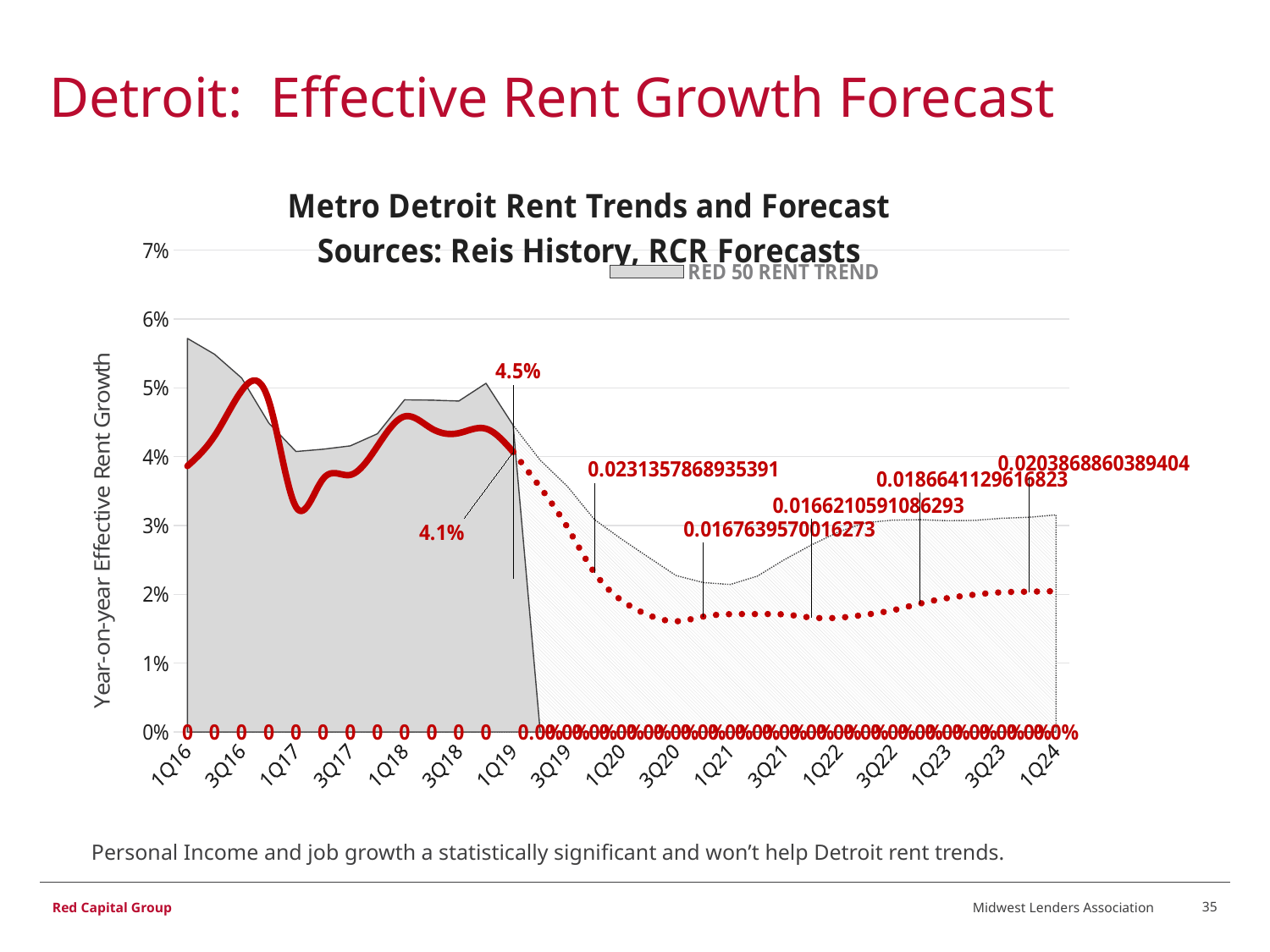
What is the highest value shown on the y axis? 7% Does the red line rise or fall between 1Q19 and 3Q20? fall What value is labeled at the end of the red dotted forecast line at 1Q24? 0.0203868860389404 Is the grey RED 50 RENT TREND area value at 1Q16 greater or less than 5%? greater What kind of chart is shown on the slide? combination area and line chart How many quarter labels are shown on the x axis? 17 Which is larger for the red line: the value at 1Q16 or the value at 3Q20? 1Q16 Is the red line value at 1Q16 greater or less than 3%? greater What series name does the chart legend show? RED 50 RENT TREND Is the red line value at 3Q20 greater or less than 2%? less What is the highest data label printed on the chart? 4.5% What is the title of the chart? Metro Detroit Rent Trends and Forecast Sources: Reis History, RCR Forecasts